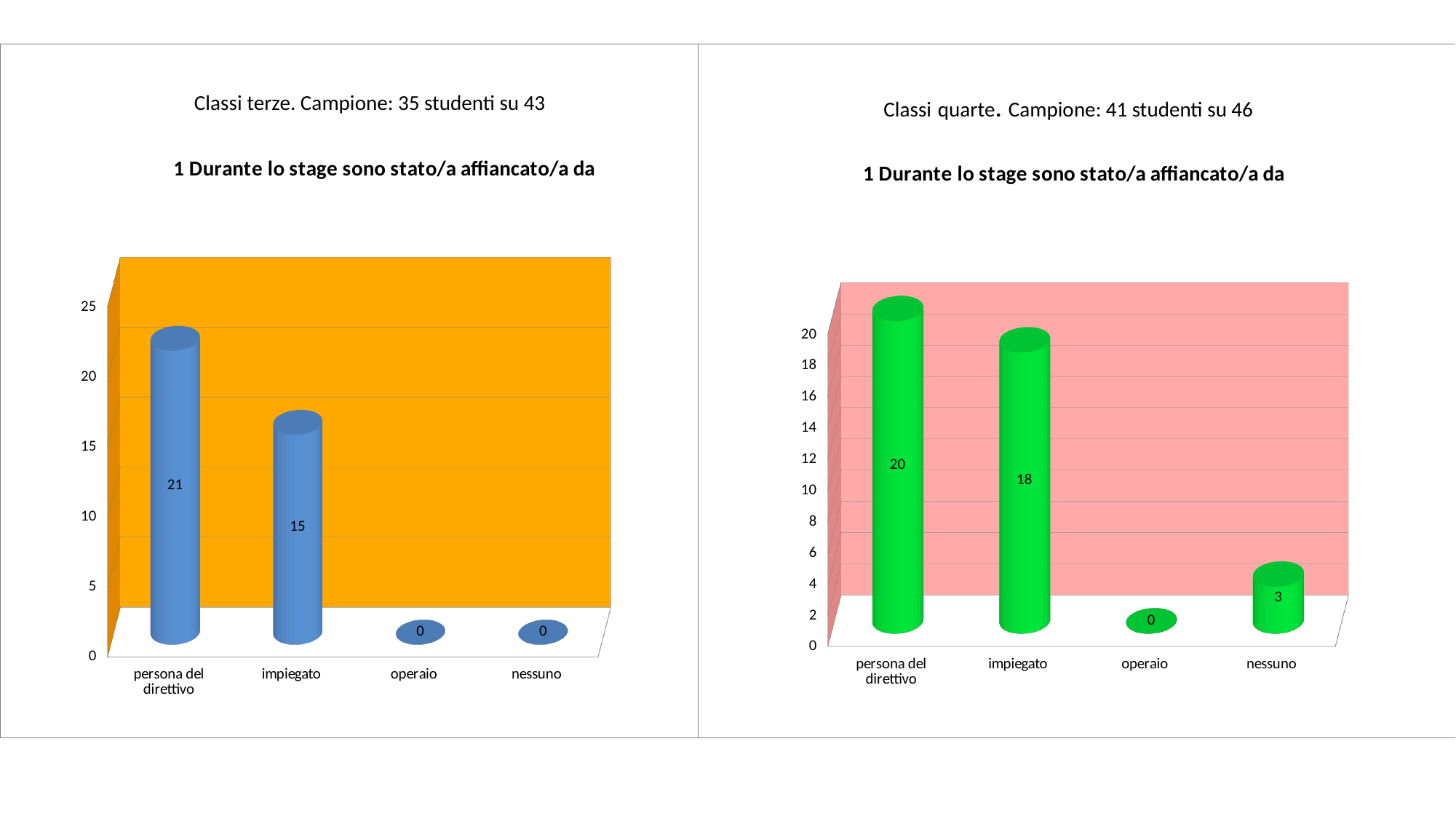
In the right chart (Classi quarte), what is the difference between persona del direttivo and nessuno? 17 In the right chart (Classi quarte), what is the value for impiegato? 18 In the left chart (Classi terze), which is larger, persona del direttivo or impiegato? persona del direttivo What kind of chart is the left chart (Classi terze)? bar chart In the left chart (Classi terze), is the value for impiegato greater or less than 10? greater What is the title of the right chart (Classi quarte)? 1 Durante lo stage sono stato/a affiancato/a da In the right chart (Classi quarte), which category has the highest value? persona del direttivo In the right chart (Classi quarte), what is the value for nessuno? 3 How many categories are shown on the x axis of the right chart (Classi quarte)? 4 In the left chart (Classi terze), what is the value for impiegato? 15 In the left chart (Classi terze), what is the difference between persona del direttivo and impiegato? 6 In the left chart (Classi terze), what is the value for persona del direttivo? 21